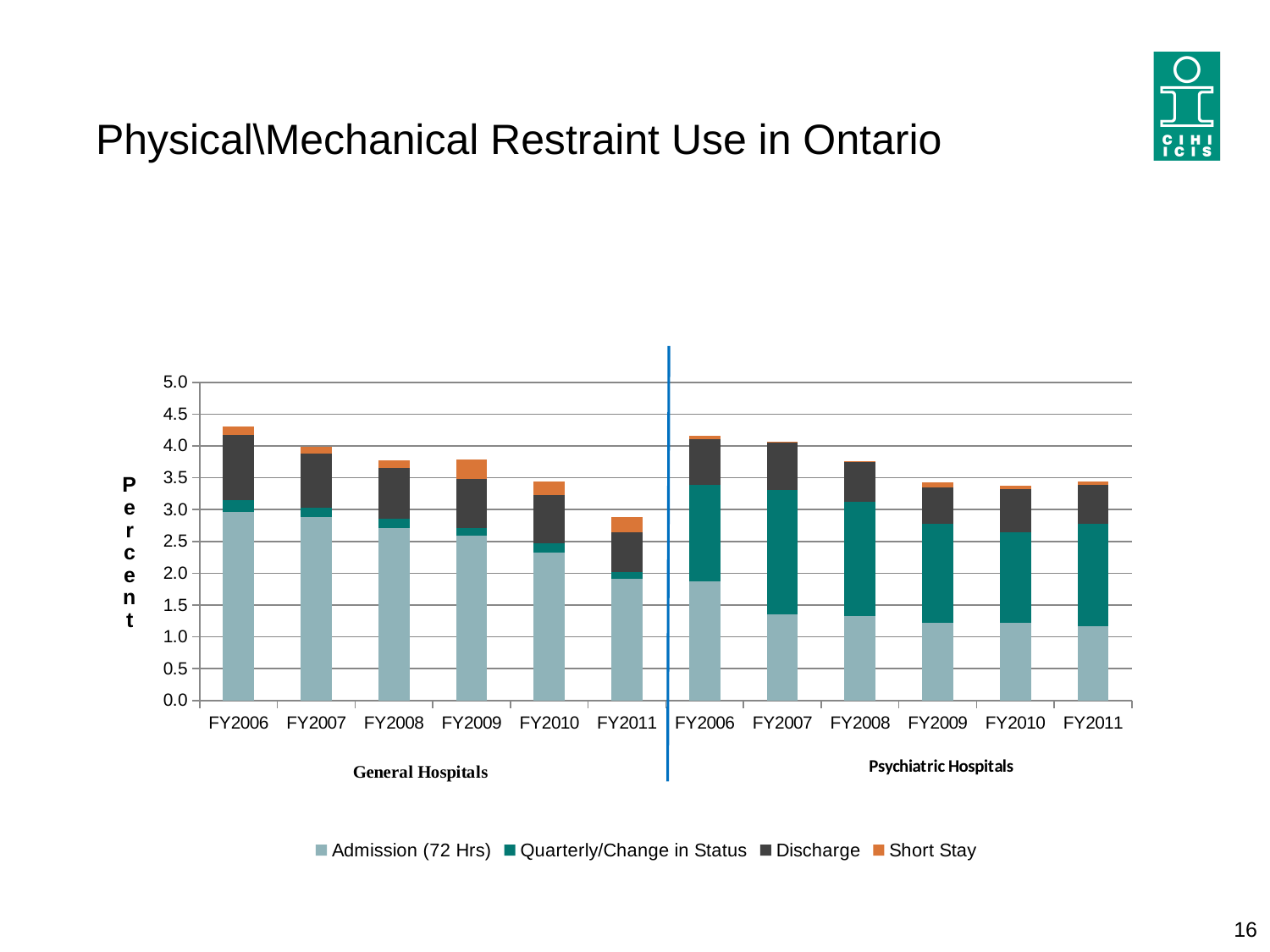
How many bars are plotted in total across both hospital groups? 12 What kind of chart is shown on the slide? Stacked bar chart How many series does the legend list? 4 Which bar has the lowest total across the whole chart? General Hospitals FY2011 Is the Admission (72 Hrs) segment for Psychiatric Hospitals FY2009 greater or less than 1.5? less What is the title of the slide? Physical\Mechanical Restraint Use in Ontario Which is larger, the Admission (72 Hrs) segment for General Hospitals FY2006 or for Psychiatric Hospitals FY2006? General Hospitals FY2006 Is the total bar height for General Hospitals FY2011 greater or less than 3.0? less Is the total bar height for Psychiatric Hospitals FY2008 greater or less than 4.0? less How many fiscal years are shown for General Hospitals? 6 Do the total bar heights for General Hospitals rise or fall from FY2006 to FY2011? fall